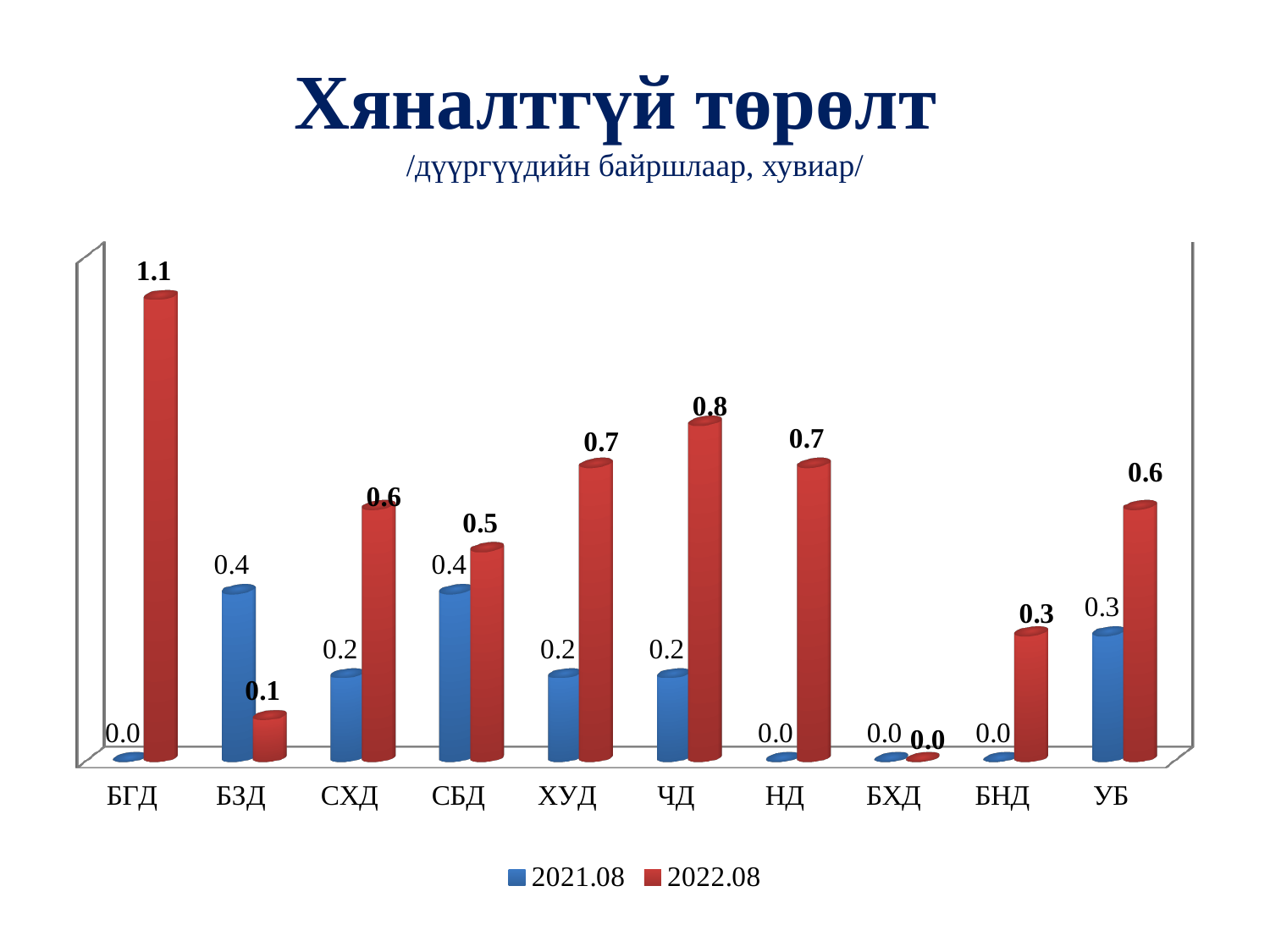
Which category has the highest value in the 2022.08 series? БГД What kind of chart is shown on the slide? Bar chart Which is larger for БЗД: the 2021.08 value or the 2022.08 value? 2021.08 What is the value for БГД in the 2022.08 series? 1.1 What is the value for УБ in the 2021.08 series? 0.3 How many categories are shown on the x axis? 10 Which category has the lowest value in the 2022.08 series? БХД What is the value for ЧД in the 2022.08 series? 0.8 What is the difference between the 2022.08 and 2021.08 values for СХД? 0.4 What is the title of the chart on the slide? Хяналтгүй төрөлт How many series does the legend list? 2 What is the value for БЗД in the 2021.08 series? 0.4